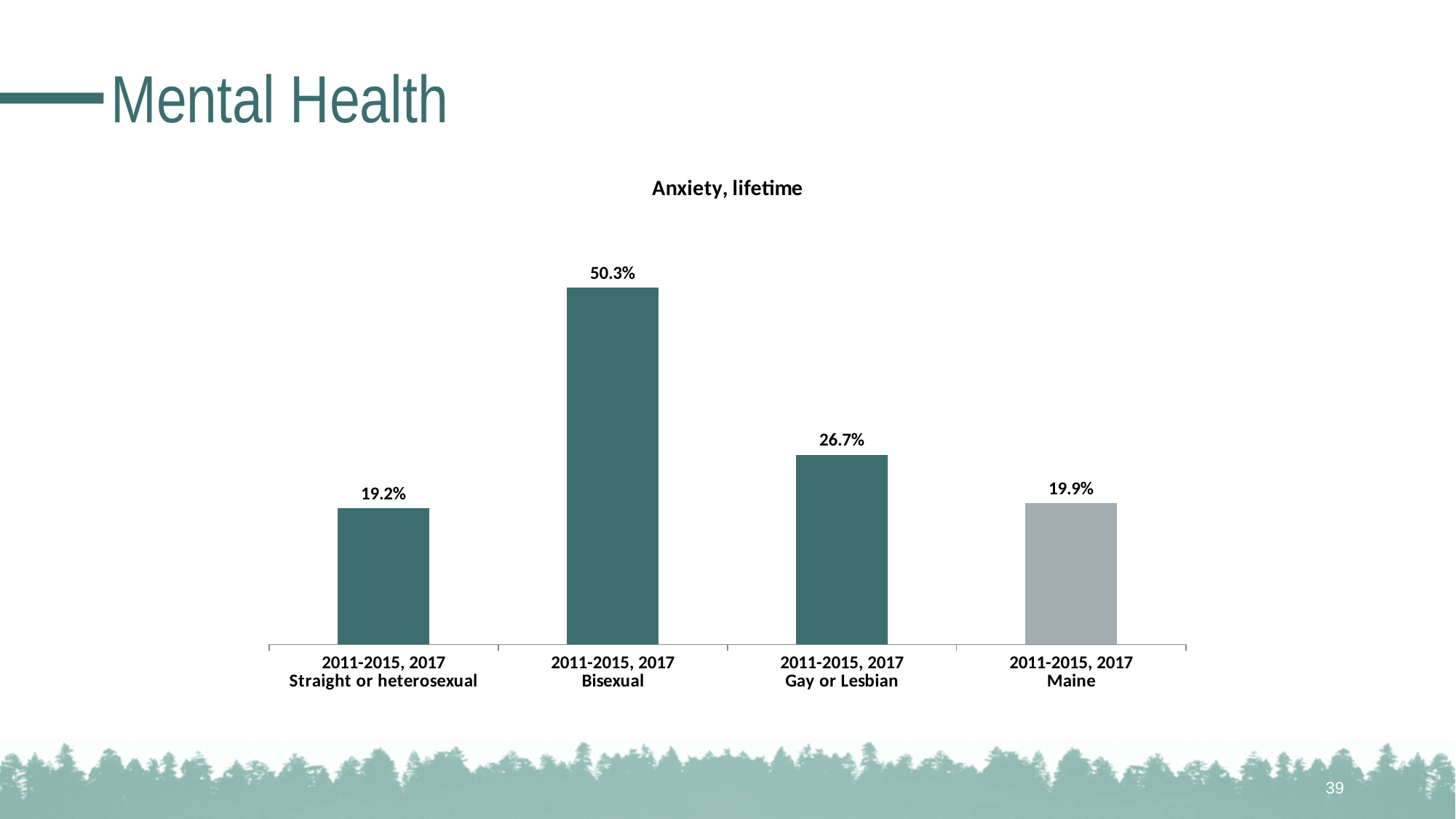
What is the value for Maine in the Anxiety, lifetime chart? 19.9% What is the difference between the Bisexual and Gay or Lesbian values in the Anxiety, lifetime chart? 23.6% How many categories are shown in the Anxiety, lifetime chart? 4 What is the title of the chart on the slide? Anxiety, lifetime What is the difference between the Maine and Straight or heterosexual values in the Anxiety, lifetime chart? 0.7% Which is larger in the Anxiety, lifetime chart: the value for Gay or Lesbian or the value for Maine? Gay or Lesbian What is the value for Straight or heterosexual in the Anxiety, lifetime chart? 19.2% What kind of chart is the Anxiety, lifetime chart? Bar chart Which category has the lowest value in the Anxiety, lifetime chart? Straight or heterosexual What is the value for Bisexual in the Anxiety, lifetime chart? 50.3% Which category has the highest value in the Anxiety, lifetime chart? Bisexual What is the value for Gay or Lesbian in the Anxiety, lifetime chart? 26.7%